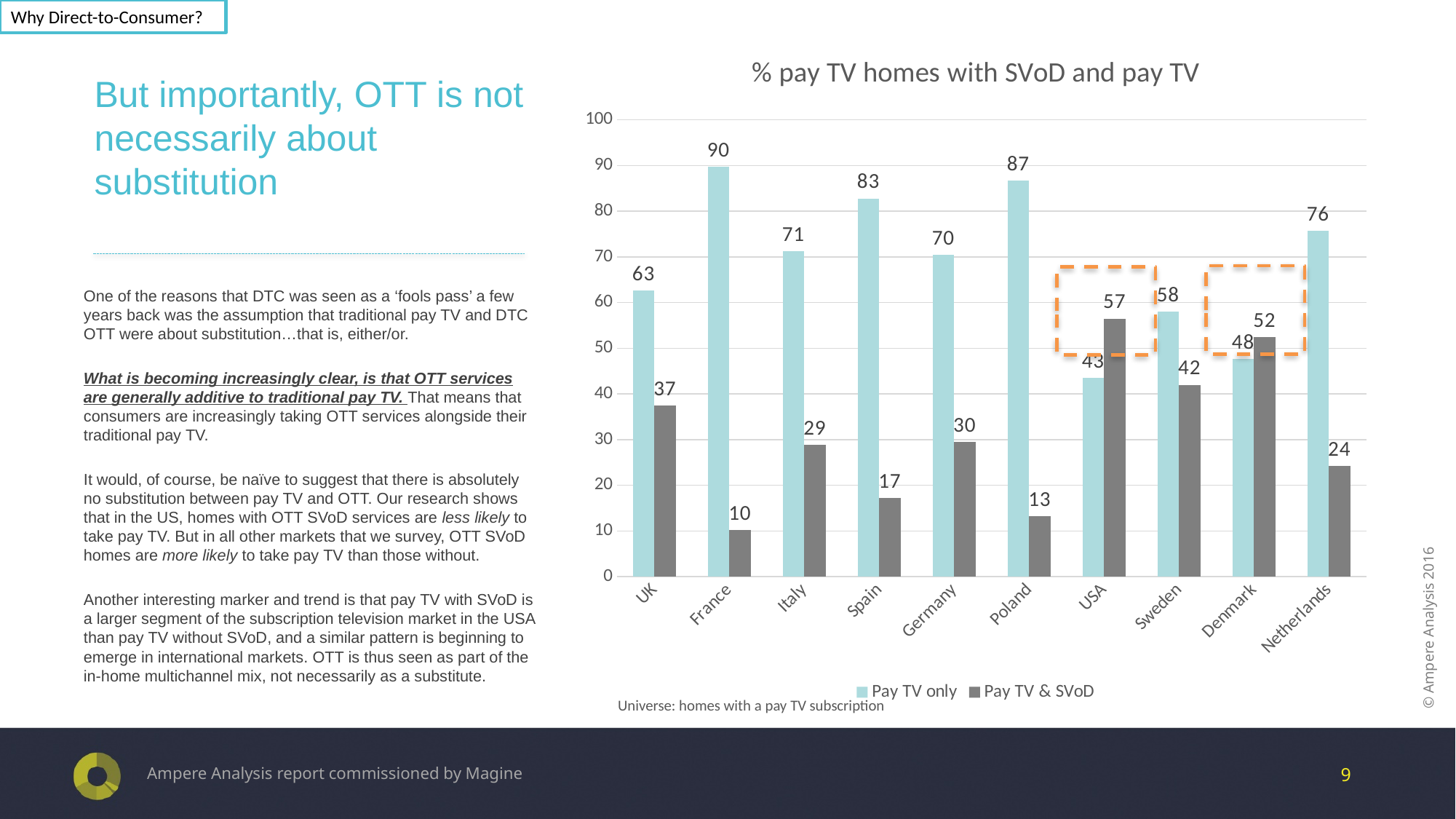
Which country has the lowest Pay TV & SVoD value? France Which country has the highest Pay TV & SVoD value? USA What is the difference between the Pay TV only and Pay TV & SVoD values for Spain? 66 What is the Pay TV only value for France? 90 What is the Pay TV & SVoD value for Sweden? 42 What is the Pay TV & SVoD value for Germany? 30 How many series does the chart's legend list? 2 Is the Pay TV only value for Netherlands greater or less than 70? greater What type of chart is shown on the slide? bar chart Which country has the highest Pay TV only value? France How many countries are shown on the x axis of the chart? 10 For Denmark, which is larger: Pay TV only or Pay TV & SVoD? Pay TV & SVoD